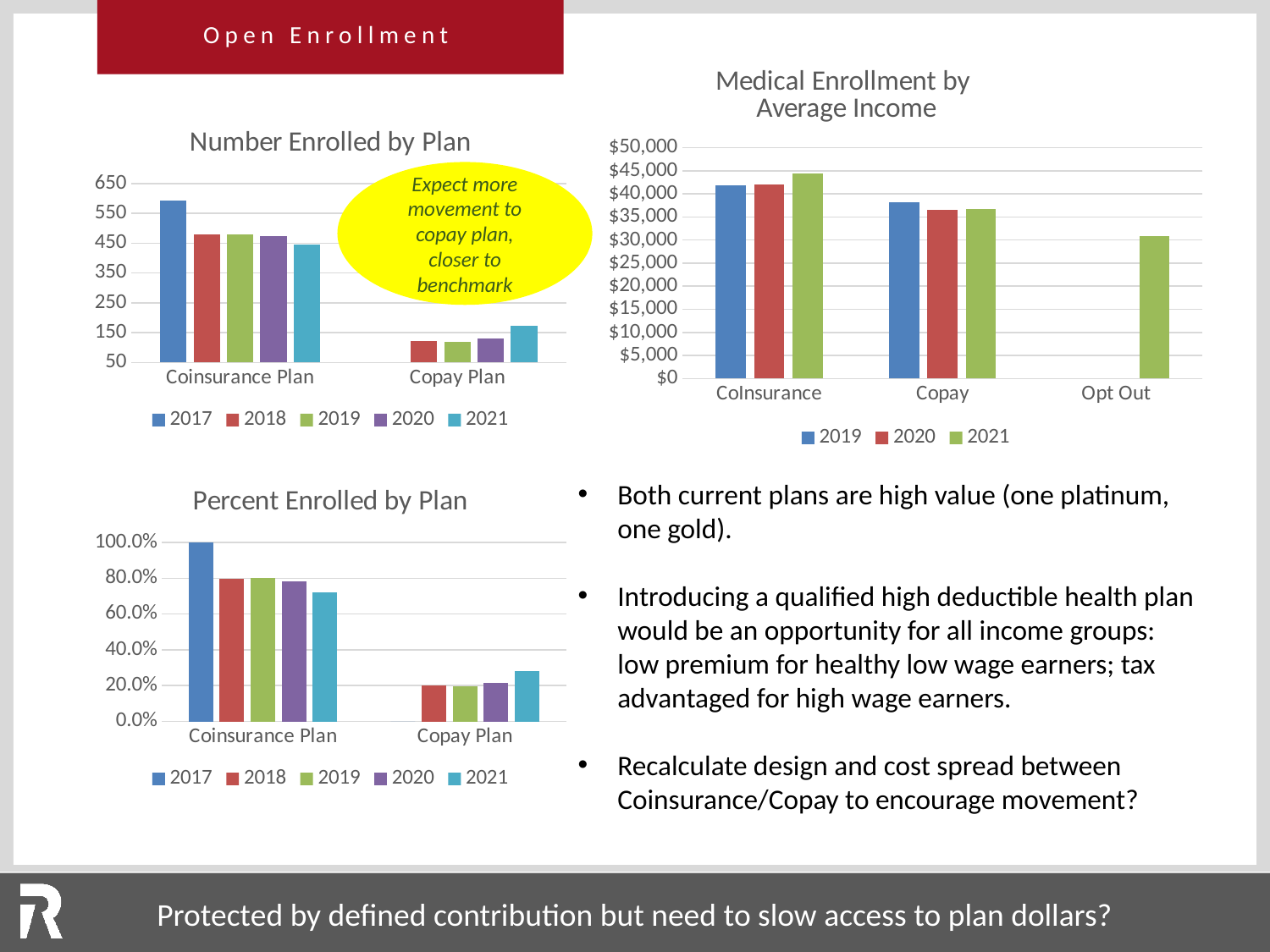
What kind of chart is "Number Enrolled by Plan"? bar chart In "Number Enrolled by Plan", do the Coinsurance Plan values rise or fall from 2017 to 2021? fall In "Number Enrolled by Plan", is the 2017 value for Coinsurance Plan greater or less than 550? greater In "Percent Enrolled by Plan", what is the 2017 value for Coinsurance Plan? 100.0% In "Number Enrolled by Plan", do the Copay Plan values rise or fall from 2018 to 2021? rise How many series does the legend of "Medical Enrollment by Average Income" list? 3 In "Medical Enrollment by Average Income", which is larger for 2019: CoInsurance or Copay? CoInsurance How many series does the legend of "Number Enrolled by Plan" list? 5 How many categories are shown on the x axis of "Medical Enrollment by Average Income"? 3 In "Medical Enrollment by Average Income", which year has the highest value for CoInsurance? 2021 In "Medical Enrollment by Average Income", is the 2021 value for Opt Out greater or less than $35,000? less In "Percent Enrolled by Plan", is the 2021 value for Copay Plan greater or less than 20.0%? greater